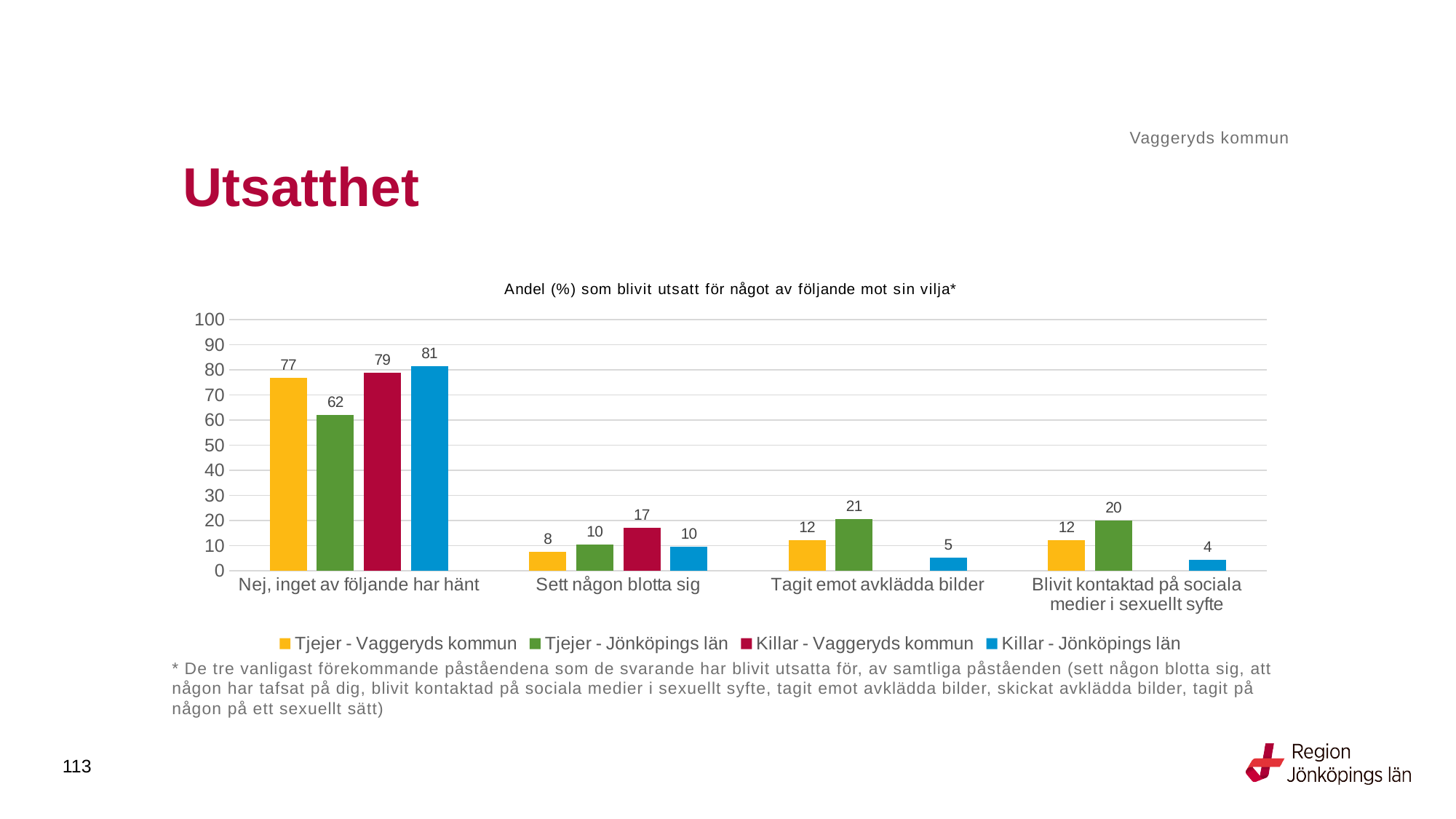
What is the value for Killar - Vaggeryds kommun in the category "Sett någon blotta sig"? 17 What is the value for Tjejer - Jönköpings län in the category "Tagit emot avklädda bilder"? 21 Which is larger in the category "Nej, inget av följande har hänt": Tjejer - Vaggeryds kommun or Tjejer - Jönköpings län? Tjejer - Vaggeryds kommun Which series has the highest value in the category "Nej, inget av följande har hänt"? Killar - Jönköpings län What is the value for Tjejer - Vaggeryds kommun in the category "Nej, inget av följande har hänt"? 77 How many categories are shown on the x axis? 4 What is the difference between Tjejer - Jönköpings län and Tjejer - Vaggeryds kommun in the category "Blivit kontaktad på sociala medier i sexuellt syfte"? 8 How many series does the legend list? 4 What is the value for Killar - Jönköpings län in the category "Blivit kontaktad på sociala medier i sexuellt syfte"? 4 What kind of chart is shown on the slide? Bar chart What is the title of the chart? Andel (%) som blivit utsatt för något av följande mot sin vilja* Which series has the lowest value in the category "Sett någon blotta sig"? Tjejer - Vaggeryds kommun